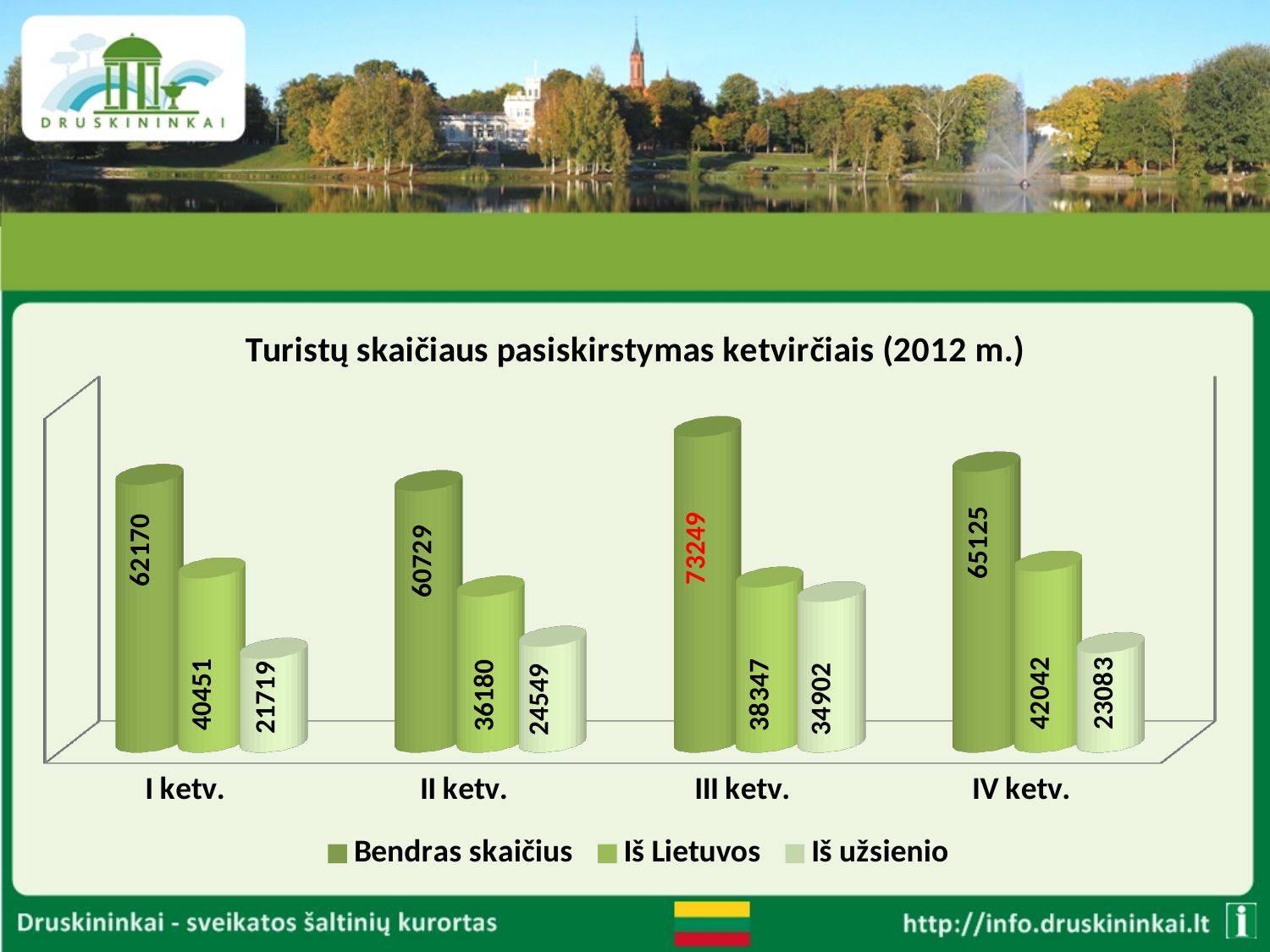
What is the difference between Bendras skaičius for III ketv. and II ketv.? 12520 Which quarter has the highest Bendras skaičius value? III ketv. How many series does the legend list? 3 Which is larger: Iš Lietuvos for II ketv. or Iš Lietuvos for IV ketv.? Iš Lietuvos for IV ketv. What is the value of Bendras skaičius for III ketv.? 73249 What is the title of the chart? Turistų skaičiaus pasiskirstymas ketvirčiais (2012 m.) How many quarters are shown on the x axis? 4 What kind of chart is shown? Bar chart What is the value of Iš Lietuvos for I ketv.? 40451 Which quarter has the lowest Iš užsienio value? I ketv. What is the value of Iš užsienio for IV ketv.? 23083 Does the Iš užsienio value rise or fall from I ketv. to III ketv.? Rise